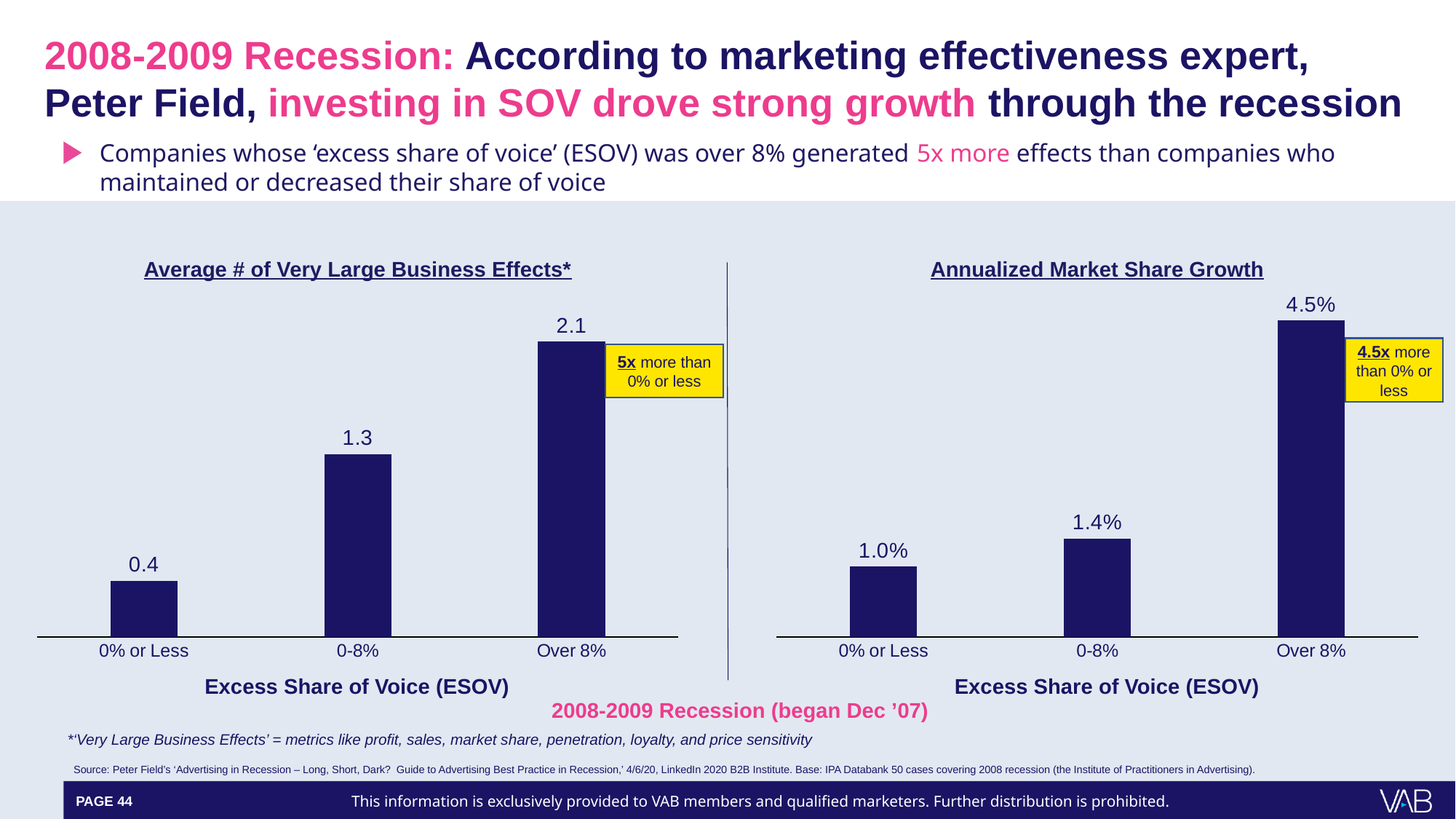
In the 'Average # of Very Large Business Effects*' chart, what is the value for '0-8%'? 1.3 In the 'Average # of Very Large Business Effects*' chart, what is the value for 'Over 8%'? 2.1 In the 'Average # of Very Large Business Effects*' chart, what is the difference between the values for 'Over 8%' and '0% or Less'? 1.7 In the 'Annualized Market Share Growth' chart, which is larger, the value for '0-8%' or the value for '0% or Less'? 0-8% In the 'Annualized Market Share Growth' chart, what is the value for 'Over 8%'? 4.5% In the 'Average # of Very Large Business Effects*' chart, which category has the lowest value? 0% or Less In the 'Average # of Very Large Business Effects*' chart, do the values rise or fall from left to right along the x axis? Rise In the 'Annualized Market Share Growth' chart, what is the value for '0% or Less'? 1.0% How many categories are shown in the 'Average # of Very Large Business Effects*' chart? 3 What kind of chart is the 'Annualized Market Share Growth' chart? Bar chart In the 'Annualized Market Share Growth' chart, what is the difference between the values for 'Over 8%' and '0-8%'? 3.1% In the 'Annualized Market Share Growth' chart, which category has the highest value? Over 8%